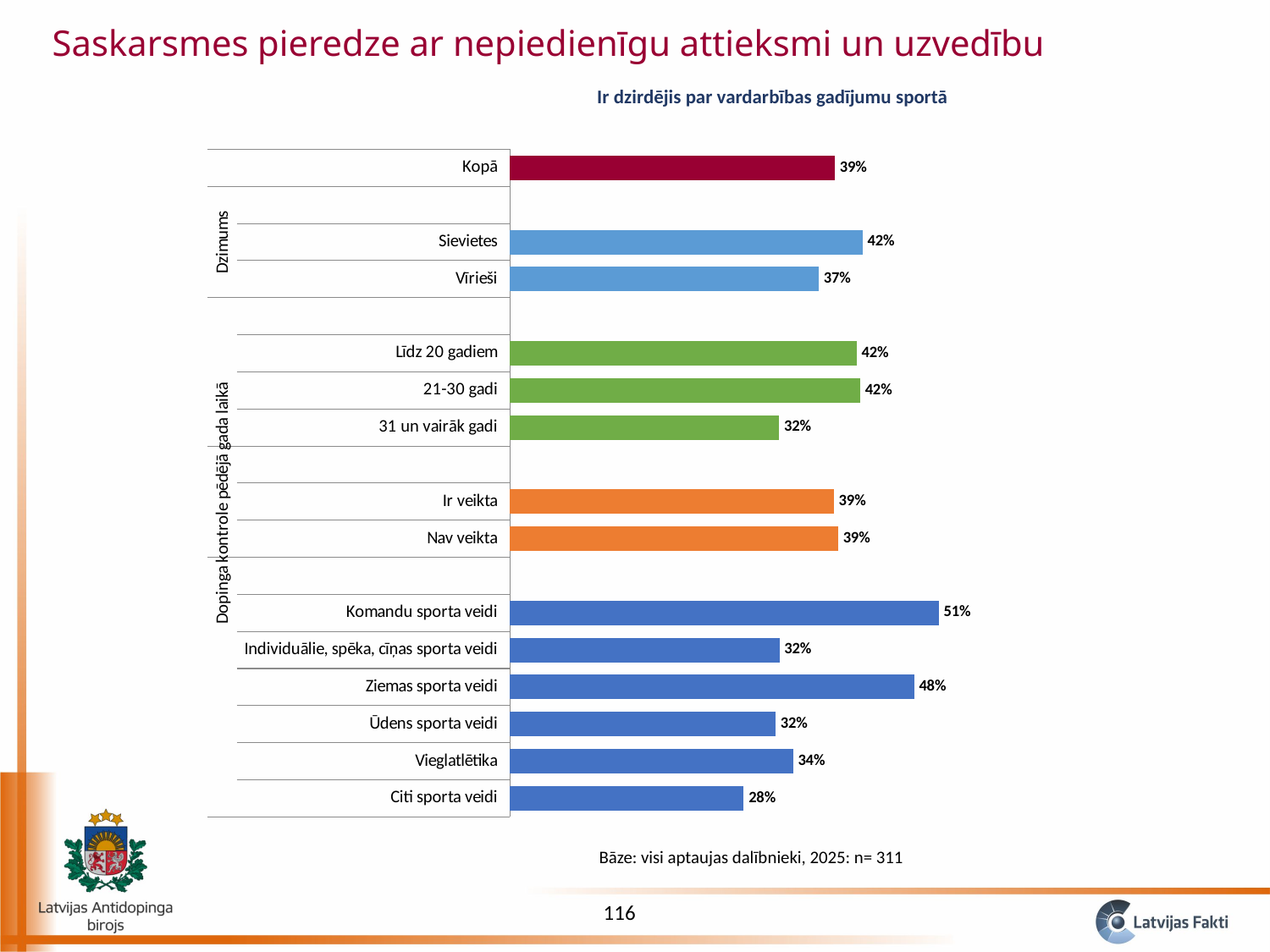
What is the difference between the values for Komandu sporta veidi and Ziemas sporta veidi? 3% What is the title of the chart? Ir dzirdējis par vardarbības gadījumu sportā Which is larger, the value for Līdz 20 gadiem or the value for 31 un vairāk gadi? Līdz 20 gadiem Which category has the highest value? Komandu sporta veidi What is the value for Citi sporta veidi? 28% Which is larger, the value for Vieglatlētika or the value for Ūdens sporta veidi? Vieglatlētika What is the difference between the values for Sievietes and Vīrieši? 5% What is the value for Kopā? 39% What is the value for Komandu sporta veidi? 51% Which category has the lowest value? Citi sporta veidi What kind of chart is shown on the slide? Bar chart What is the value for Sievietes? 42%